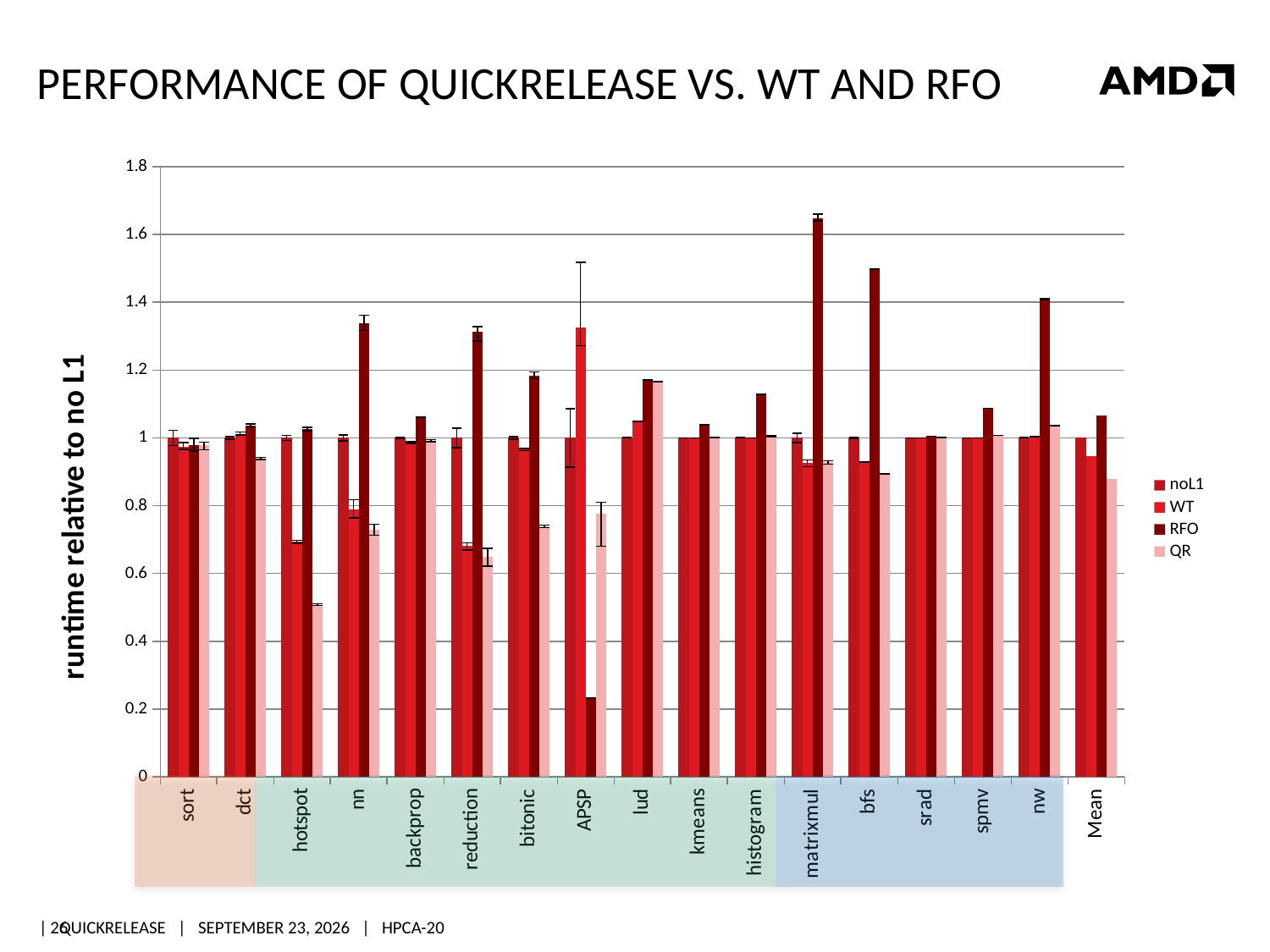
What is the label of the y axis? runtime relative to no L1 Is the RFO value for matrixmul greater or less than 1.4? greater What kind of chart is shown on the slide? bar chart Is the RFO value for nn greater or less than 1.2? greater Which is larger, the QR value for hotspot or the QR value for nn? nn How many series does the legend list? 4 Which category has the lowest RFO bar? APSP Which category has the highest RFO bar? matrixmul Which is larger, the RFO value for matrixmul or the RFO value for bfs? matrixmul Is the QR value for hotspot greater or less than 0.6? less How many categories are shown along the x axis? 17